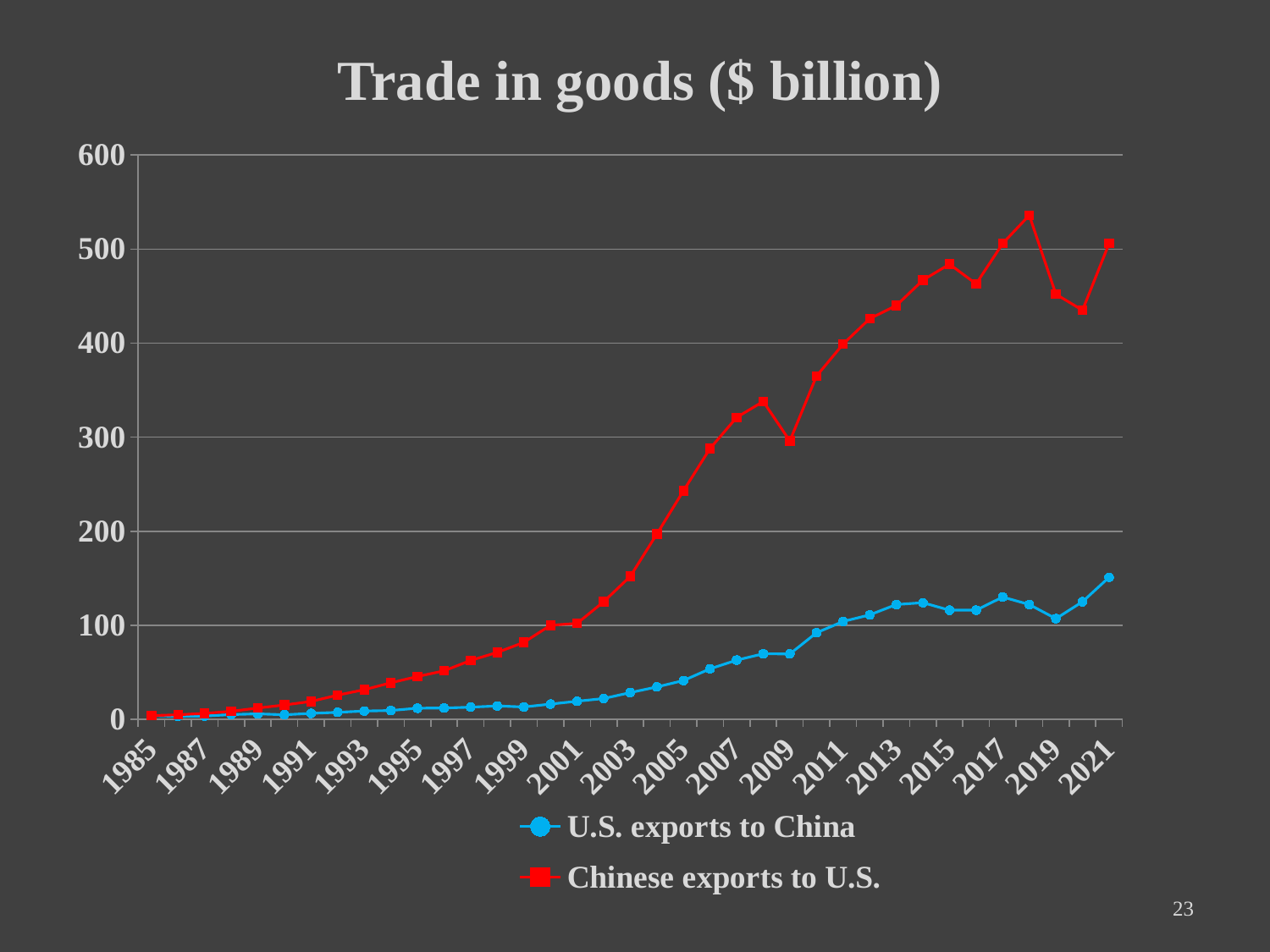
How many series does the legend list? 2 Is the value for Chinese exports to U.S. in 2018 greater or less than 500? greater In 2021, which is larger: U.S. exports to China or Chinese exports to U.S.? Chinese exports to U.S. Which series is drawn in red? Chinese exports to U.S. What is the title of the chart? Trade in goods ($ billion) Overall, do U.S. exports to China rise or fall from 1985 to 2021? rise What kind of chart is shown on the slide? line chart Is the value for Chinese exports to U.S. in 2010 greater or less than 400? less In which year do Chinese exports to U.S. reach their highest value? 2018 Is the value for U.S. exports to China in 2021 greater or less than 100? greater In which year are Chinese exports to U.S. at their lowest? 1985